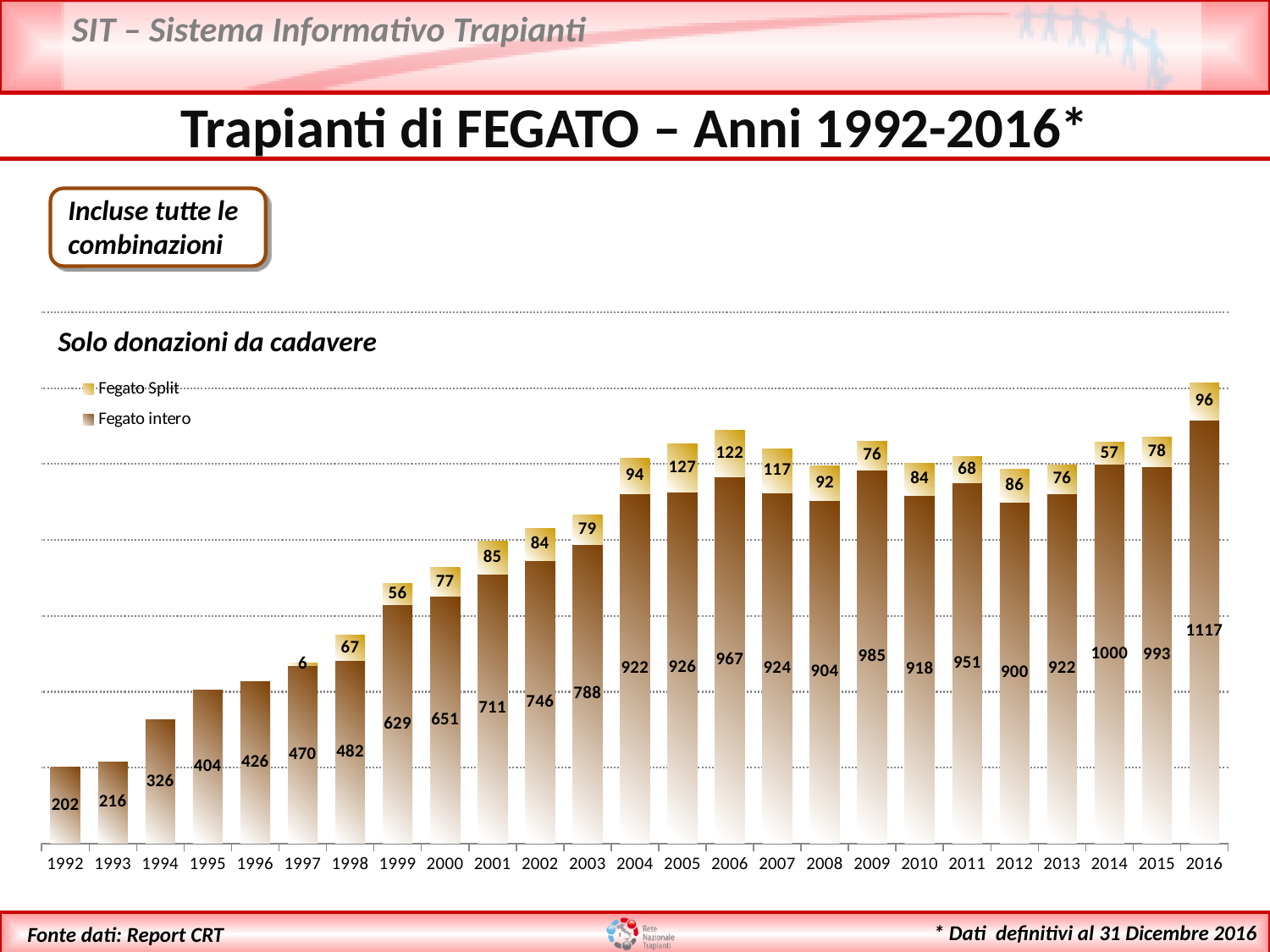
How many years are shown on the x axis? 25 What kind of chart is shown on the slide? Stacked bar chart What is the value of Fegato intero for 2016? 1117 What is the value of Fegato intero for 1992? 202 Which year has the lowest value for Fegato intero? 1992 What is the total of the stacked bar for 2016? 1213 What is the value of Fegato Split for 2005? 127 What are the two series named in the legend? Fegato Split and Fegato intero How many series does the legend list? 2 Which year has the highest value for Fegato Split? 2005 Which is larger, the Fegato intero value for 2009 or for 2011? 2009 What is the difference between the Fegato intero values for 2016 and 2015? 124